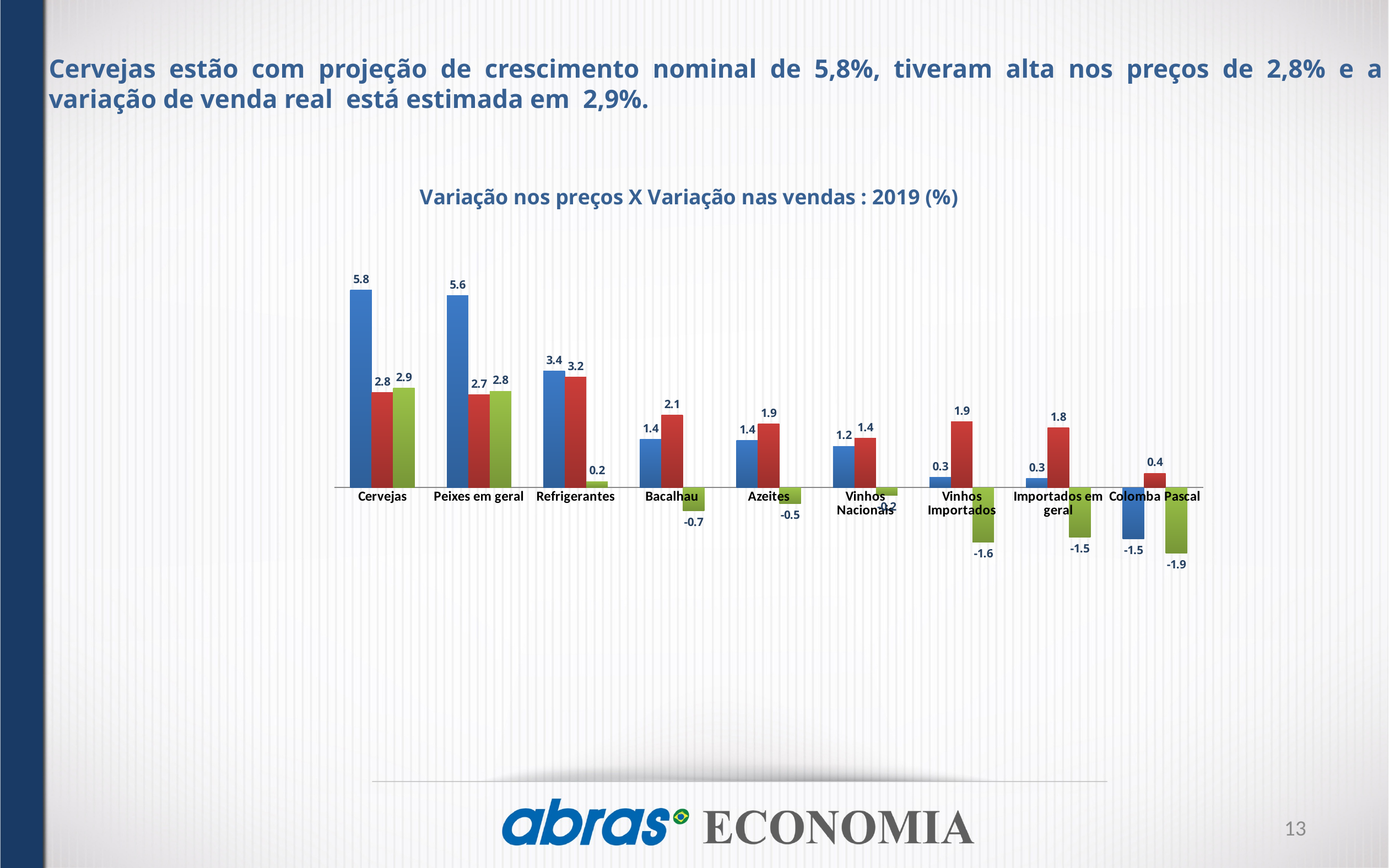
What is the value of the red bar for Vinhos Importados? 1.9 What kind of chart is shown on the slide? bar chart What is the value of the blue bar for Cervejas? 5.8 What is the value of the green bar for Colomba Pascal? -1.9 What is the value of the red bar for Refrigerantes? 3.2 How many categories are shown on the x axis? 9 Which is larger for Bacalhau, the blue bar or the red bar? the red bar What is the difference between the blue bar and the red bar for Peixes em geral? 2.9 Which category has the highest blue bar? Cervejas What is the title of the chart? Variação nos preços X Variação nas vendas : 2019 (%) Do the blue bars generally rise or fall from Cervejas to Colomba Pascal? fall Which category has the lowest green bar? Colomba Pascal